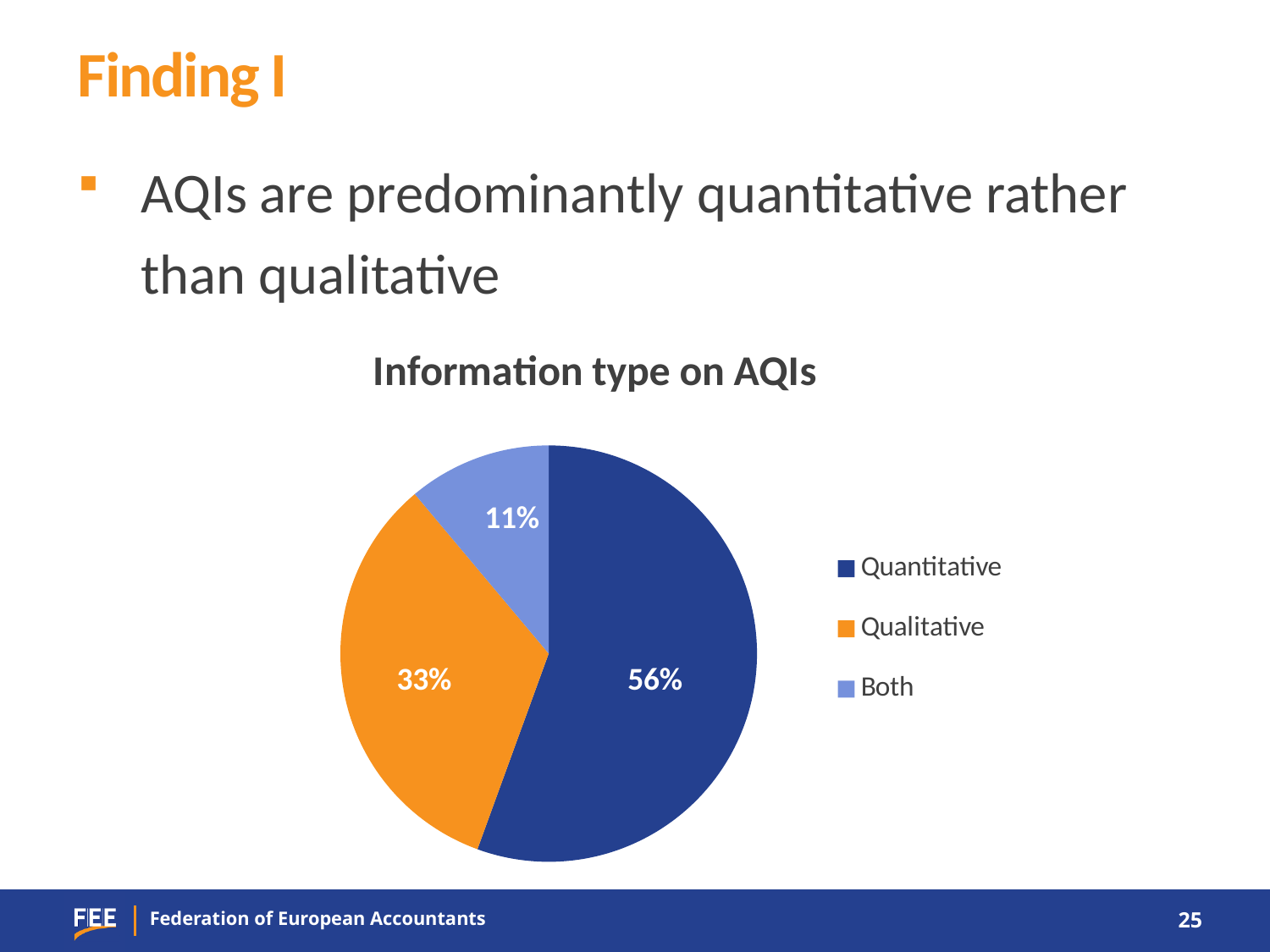
What is the title of the chart? Information type on AQIs What is the difference in percentage points between the Quantitative and Qualitative slices? 23 Which is larger, the Qualitative slice or the Both slice? Qualitative What share of the pie is Both? 11% What type of chart is shown on the slide? Pie chart Which category has the largest slice of the pie? Quantitative What share of the pie is Quantitative? 56% What colour is the Qualitative slice? Orange How many categories does the legend list? 3 What is the difference in percentage points between the Qualitative and Both slices? 22 Which category has the smallest slice of the pie? Both What share of the pie is Qualitative? 33%